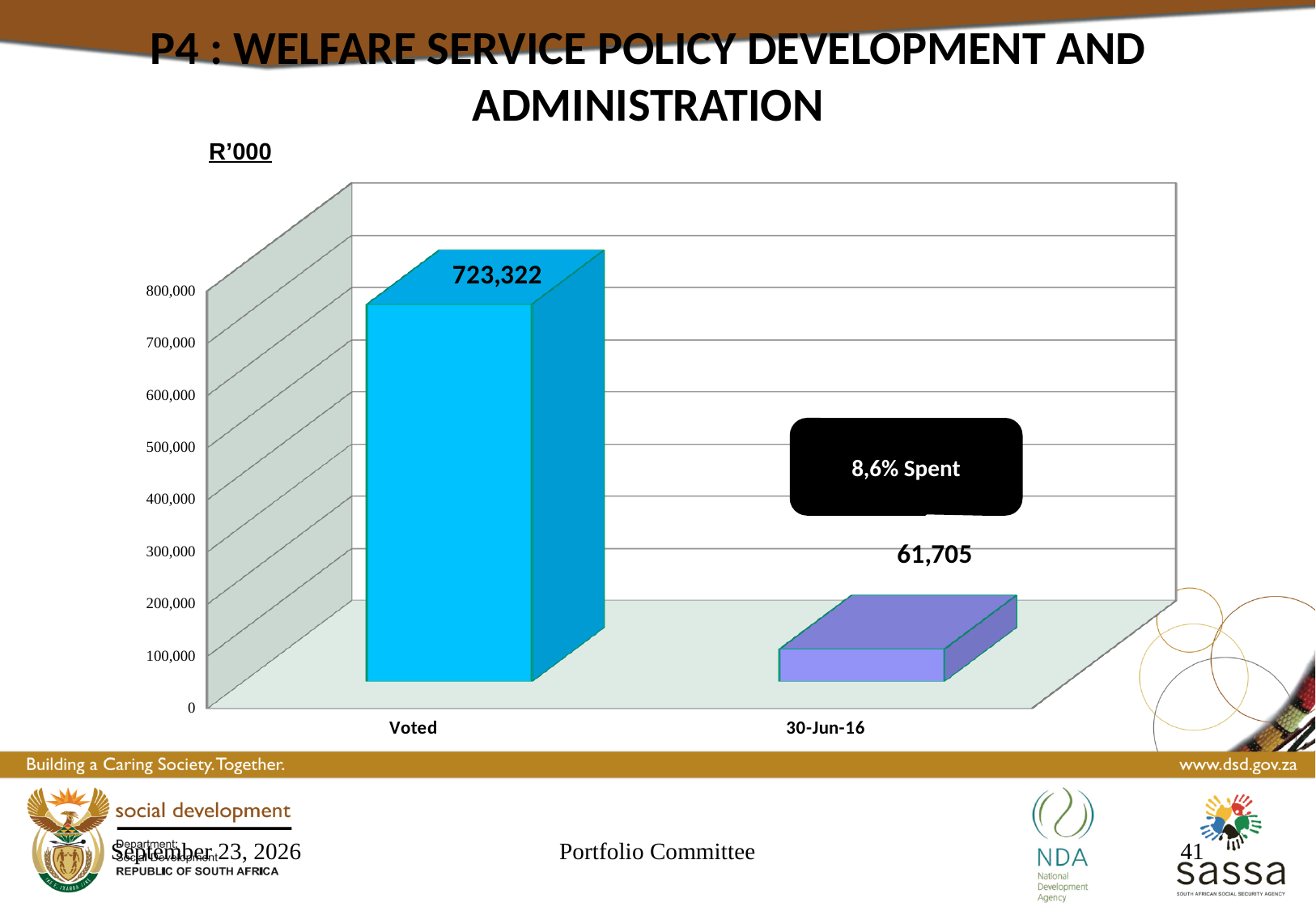
What is the value for Voted? 723,322 What is the value for 30-Jun-16? 61,705 What is the difference between the Voted value and the 30-Jun-16 value? 661,617 What percentage spent is shown in the callout on the chart? 8,6% Spent What unit label is shown above the chart? R'000 Which is larger, the value for Voted or the value for 30-Jun-16? Voted Which category has the lowest value? 30-Jun-16 How many categories are shown on the x axis? 2 Which category has the highest value? Voted Is the value for 30-Jun-16 greater or less than 100,000? less What kind of chart is shown on the slide? Bar chart Is the value for Voted greater or less than 700,000? greater